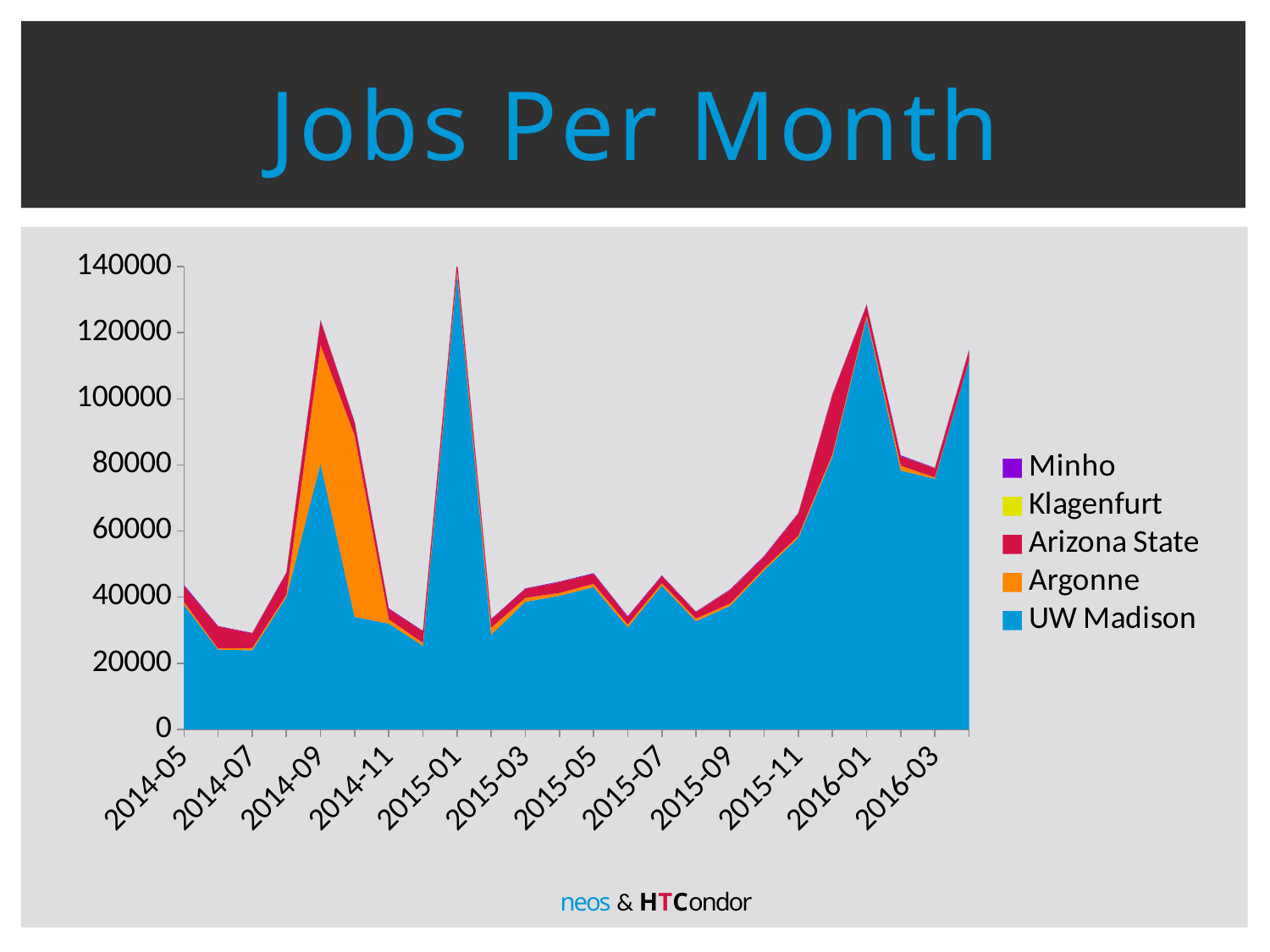
Which peak is higher, 2015-01 or 2016-01? 2015-01 Is the total value for 2015-11 greater or less than 40000? greater Is the total value for 2016-03 greater or less than 100000? less Is the total value for 2015-01 greater or less than 120000? greater What kind of chart is shown on the slide? Area chart How many series does the legend list? 5 Which series is shown in orange? Argonne Which series accounts for the largest share of jobs across the chart? UW Madison What is the title of the chart? Jobs Per Month Which month has the highest total jobs? 2015-01